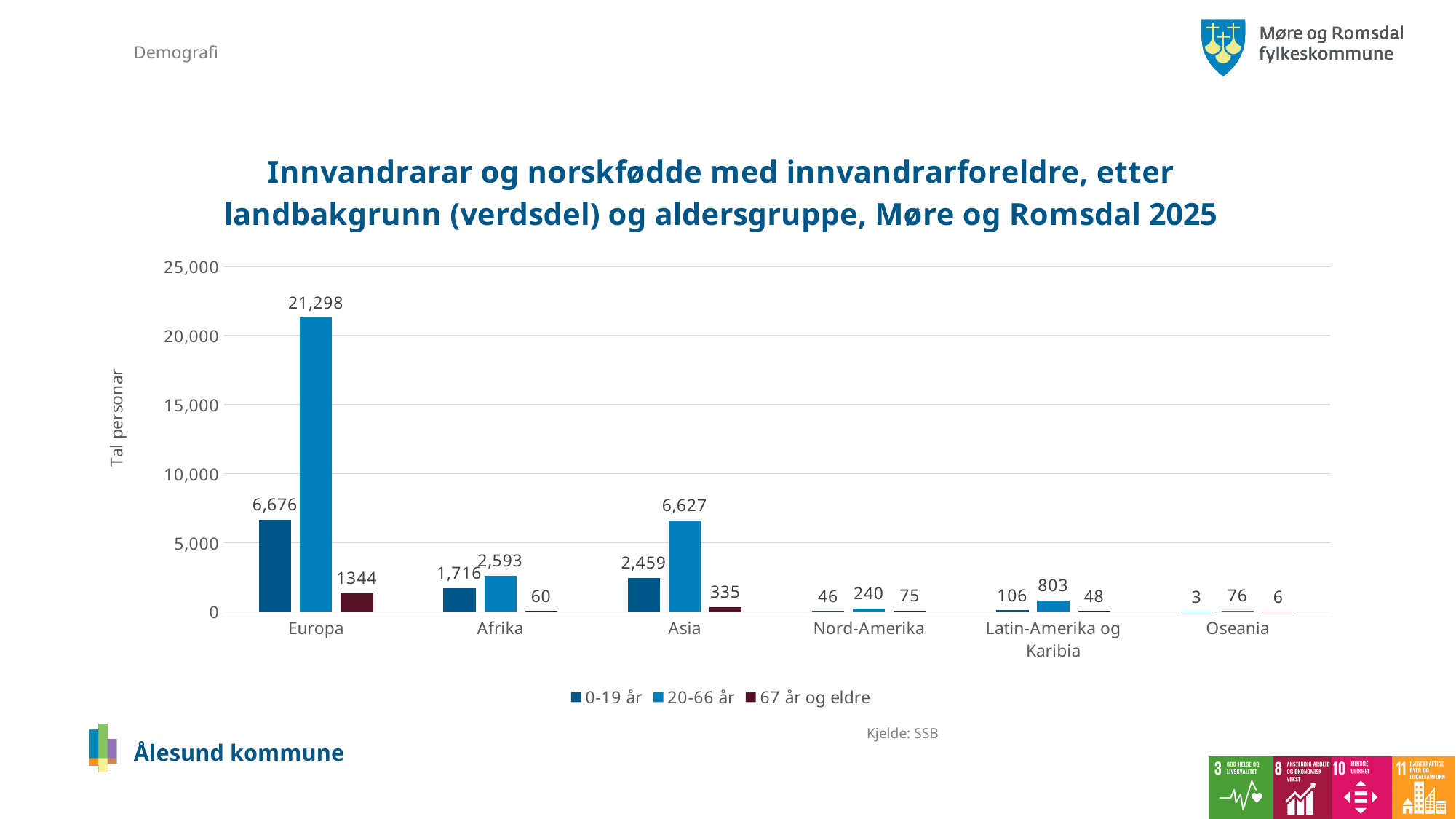
How many categories are shown on the x axis? 6 What is the difference between the 20-66 år value and the 0-19 år value for Afrika? 877 What is the value for Oseania in the 20-66 år series? 76 What is the value for Europa in the 20-66 år series? 21,298 How many series does the legend list? 3 What kind of chart is shown on the slide? Bar chart Which category has the lowest value in the 0-19 år series? Oseania What is the value for Latin-Amerika og Karibia in the 67 år og eldre series? 48 Which is larger for Nord-Amerika: the 0-19 år value or the 67 år og eldre value? 67 år og eldre Which category has the highest value in the 20-66 år series? Europa What is the value for Asia in the 0-19 år series? 2,459 What is the label of the y axis? Tal personar